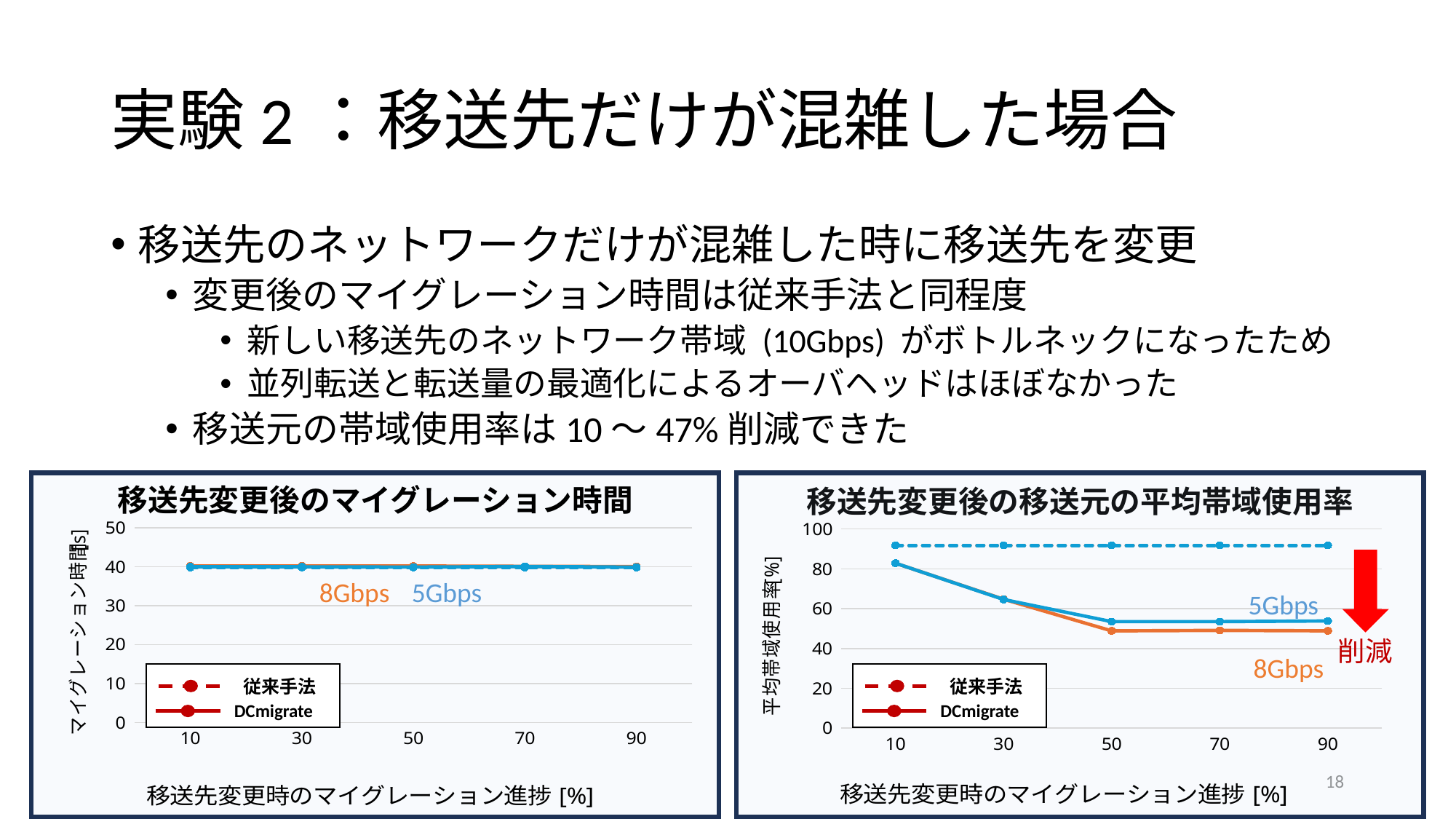
In the right chart (移送先変更後の移送元の平均帯域使用率), is the dashed 従来手法 line greater or less than 80? greater In the right chart (移送先変更後の移送元の平均帯域使用率), does the solid DCmigrate 5Gbps line rise or fall as migration progress increases from 10 to 50? fall In the right chart (移送先変更後の移送元の平均帯域使用率), is the DCmigrate 8Gbps value at progress 90 greater or less than 60? less What is the x-axis label of the right chart (移送先変更後の移送元の平均帯域使用率)? 移送先変更時のマイグレーション進捗 [%] What kind of chart is the right chart titled 移送先変更後の移送元の平均帯域使用率? line chart In the right chart (移送先変更後の移送元の平均帯域使用率), how many entries does the legend list? 2 In the left chart (移送先変更後のマイグレーション時間), is the migration time at progress 10 greater or less than 30? greater In the left chart (移送先変更後のマイグレーション時間), how many x-axis points (migration progress values) are plotted? 5 In the left chart (移送先変更後のマイグレーション時間), do the migration time lines rise, fall, or stay flat across the x axis? stay flat What kind of chart is the left chart titled 移送先変更後のマイグレーション時間? line chart In the right chart (移送先変更後の移送元の平均帯域使用率), at progress 90, which is higher: the dashed 従来手法 line or the solid DCmigrate 8Gbps line? 従来手法